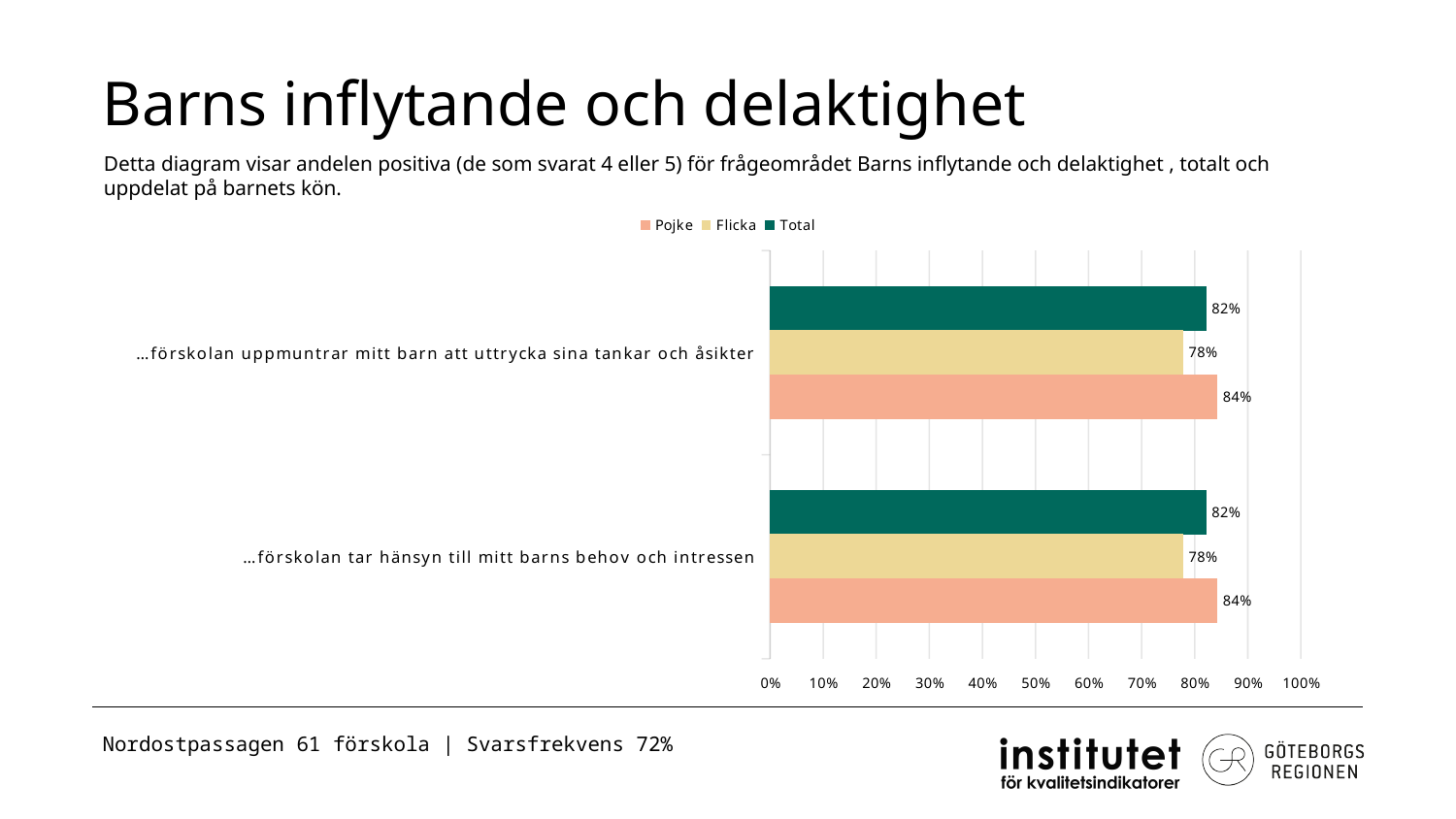
Which series has the lowest value for "…förskolan uppmuntrar mitt barn att uttrycka sina tankar och åsikter"? Flicka What is the value for Pojke for "…förskolan uppmuntrar mitt barn att uttrycka sina tankar och åsikter"? 84% Is the Flicka value for "…förskolan tar hänsyn till mitt barns behov och intressen" greater or less than 80%? less What is the difference between the Pojke and Flicka values for "…förskolan tar hänsyn till mitt barns behov och intressen"? 6 percentage points What is the value for Flicka for "…förskolan tar hänsyn till mitt barns behov och intressen"? 78% How many series does the legend list? 3 What kind of chart is shown on the slide? Bar chart Which series has the highest value for "…förskolan tar hänsyn till mitt barns behov och intressen"? Pojke What is the Total value for "…förskolan uppmuntrar mitt barn att uttrycka sina tankar och åsikter"? 82% Which series is shown in dark green in the legend? Total How many question categories are shown on the chart? 2 For "…förskolan uppmuntrar mitt barn att uttrycka sina tankar och åsikter", is the Total value larger or the Flicka value? Total